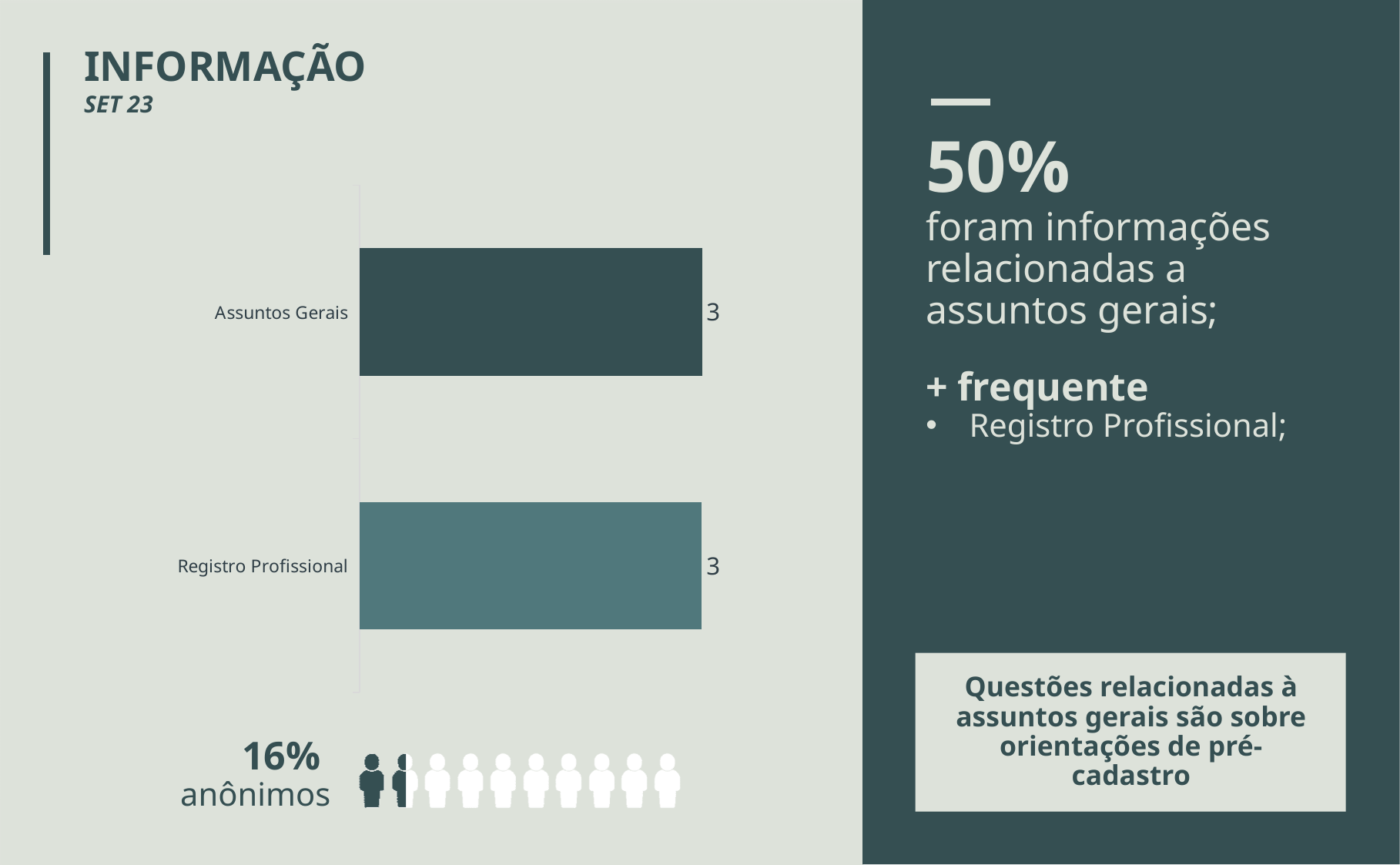
What is the value for Registro Profissional? 3 What is the difference between the values for Assuntos Gerais and Registro Profissional? 0 Are the bars in the chart horizontal or vertical? horizontal How many categories are shown in the bar chart? 2 Which category is listed at the top of the bar chart? Assuntos Gerais What is the title shown above the chart on the slide? INFORMAÇÃO What is the value for Assuntos Gerais? 3 Is the value for Assuntos Gerais larger than, smaller than, or equal to the value for Registro Profissional? equal What kind of chart is shown on the slide? bar chart